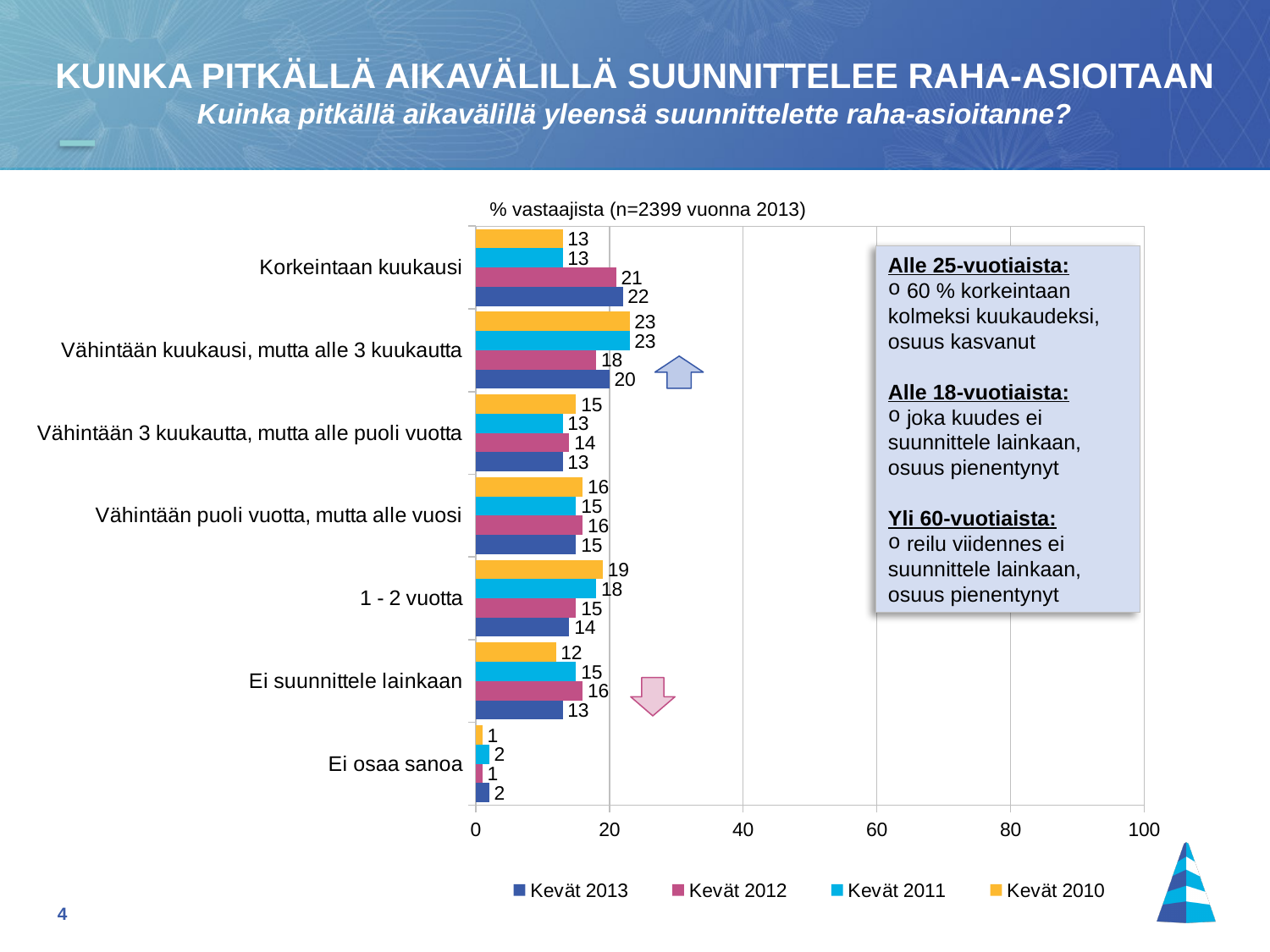
How many categories are shown on the chart? 7 What kind of chart is shown on the slide? bar chart What is the value for Kevät 2012 in the category 'Ei suunnittele lainkaan'? 16 For '1 - 2 vuotta', which is larger: the Kevät 2010 value or the Kevät 2013 value? Kevät 2010 Which category has the highest value for Kevät 2013? Korkeintaan kuukausi What is the value for Kevät 2013 in the category 'Korkeintaan kuukausi'? 22 Is the Kevät 2012 value for 'Korkeintaan kuukausi' greater or less than 20? greater Which category has the lowest value for Kevät 2010? Ei osaa sanoa What is the axis label shown above the chart? % vastaajista (n=2399 vuonna 2013) How many series does the legend list? 4 What is the value for Kevät 2010 in the category 'Vähintään kuukausi, mutta alle 3 kuukautta'? 23 What is the difference between the Kevät 2013 and Kevät 2010 values for 'Korkeintaan kuukausi'? 9